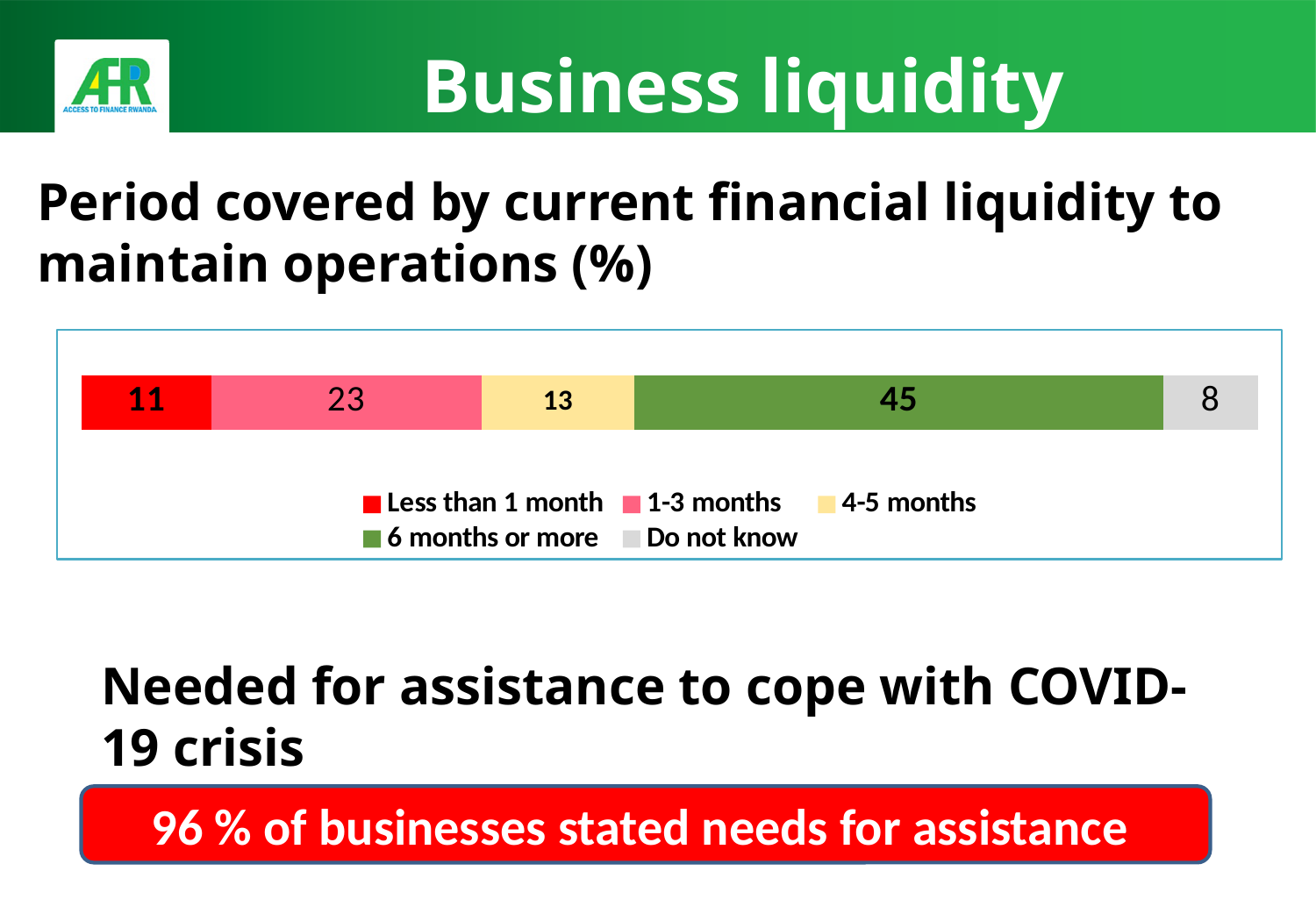
What is the value for the '4-5 months' segment? 13 Which is larger, the value for 'Less than 1 month' or the value for '4-5 months'? 4-5 months What percentage of businesses answered 'Do not know'? 8 What percentage of businesses have liquidity to maintain operations for less than 1 month? 11 How many categories does the legend list? 5 What is the difference between the '6 months or more' value and the '1-3 months' value? 22 What type of chart is shown on the slide? Stacked bar chart Which category has the largest share of the bar? 6 months or more What is the total of all segments in the stacked bar? 100 What is the value for '6 months or more'? 45 Which category has the smallest value? Do not know What is the value for the '1-3 months' segment? 23